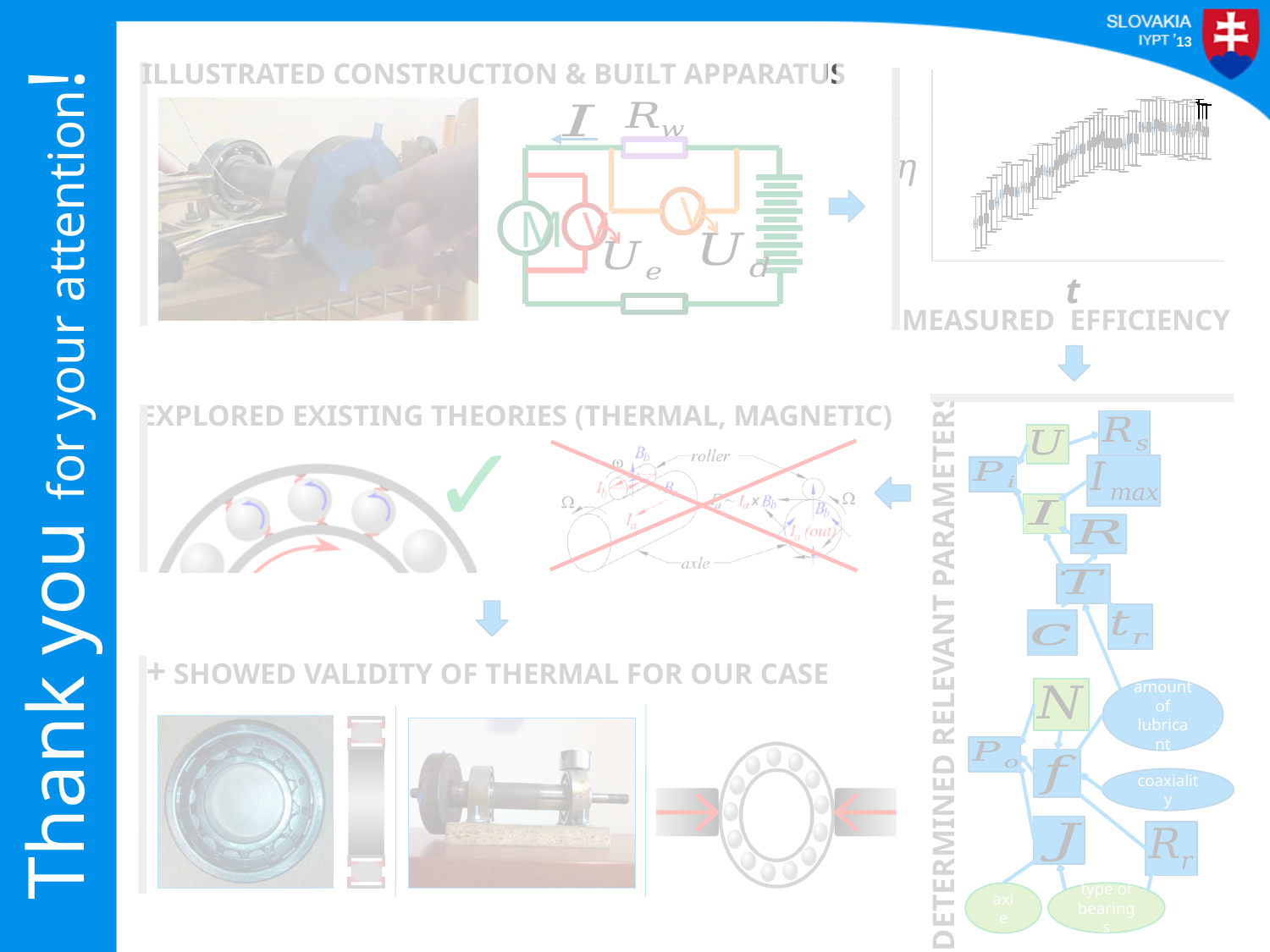
What is the title of the chart in the top right of the slide? MEASURED EFFICIENCY In the MEASURED EFFICIENCY chart, do the plotted values rise or fall as t increases? rise In the MEASURED EFFICIENCY chart, what symbol labels the vertical axis? η What kind of chart is the MEASURED EFFICIENCY chart? scatter chart with error bars